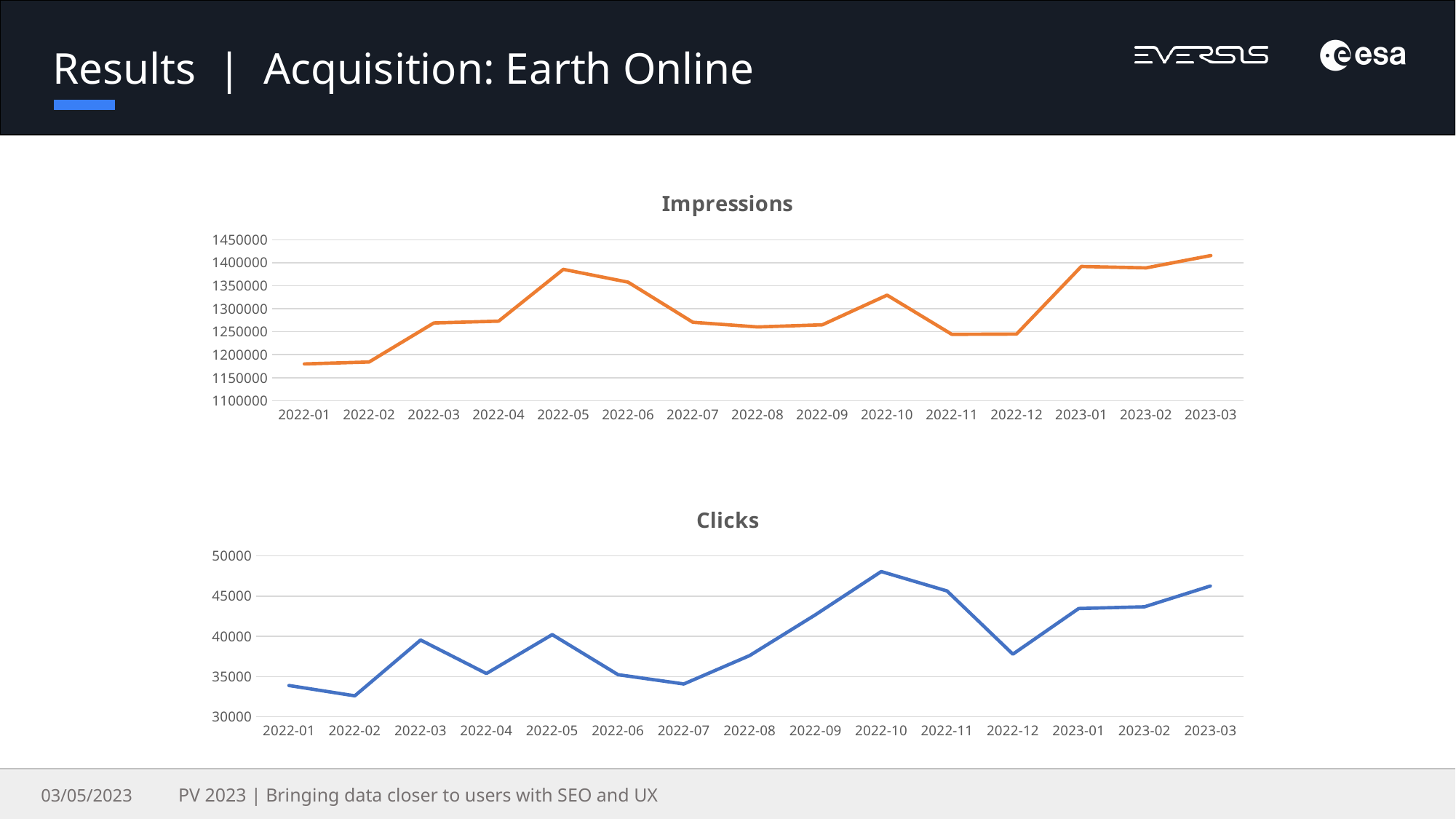
On the Clicks chart, is the value for 2022-12 greater or less than 40000? less On the Clicks chart, which month has the lowest value? 2022-02 On the Clicks chart, is the value for 2022-10 greater or less than 45000? greater On the Impressions chart, is the value for 2022-01 greater or less than 1200000? less On the Clicks chart, which month has the highest value? 2022-10 How many data points are plotted on the Clicks chart? 15 What kind of chart is the Impressions chart? line chart On the Impressions chart, which month has the highest value? 2023-03 What colour is the line on the Clicks chart? blue On the Clicks chart, do the values rise or fall from 2022-07 to 2022-10? rise On the Impressions chart, which is larger, the value for 2022-05 or 2022-06? 2022-05